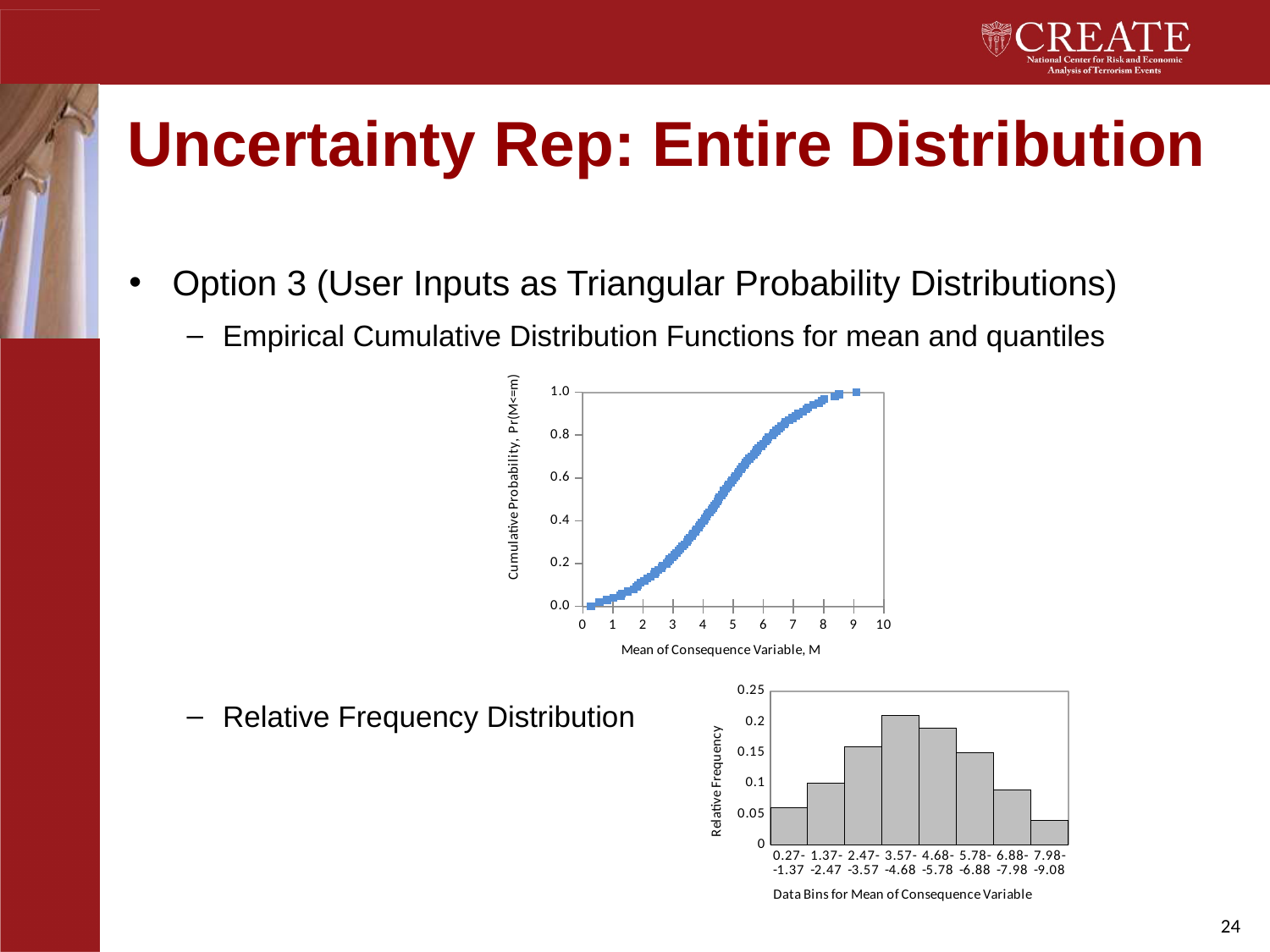
In the bottom bar chart (Relative Frequency), is the value for the 1.37-2.47 bin greater or less than 0.15? less In the top chart (Cumulative Probability), do the plotted values rise or fall as the Mean of Consequence Variable increases along the x axis? rise What is the x-axis title of the top chart on the slide? Mean of Consequence Variable, M What is the x-axis title of the bottom bar chart on the slide? Data Bins for Mean of Consequence Variable In the bottom bar chart (Relative Frequency), which bin has the larger value: 2.47-3.57 or 6.88-7.98? 2.47-3.57 In the bottom bar chart (Relative Frequency), which data bin has the highest relative frequency? 3.57-4.68 What kind of chart is the bottom chart titled 'Relative Frequency' on the slide? bar chart In the bottom bar chart (Relative Frequency), how many data bins are shown on the x axis? 8 In the bottom bar chart (Relative Frequency), which data bin has the lowest relative frequency? 7.98-9.08 In the bottom bar chart (Relative Frequency), is the value for the 4.68-5.78 bin greater or less than 0.15? greater